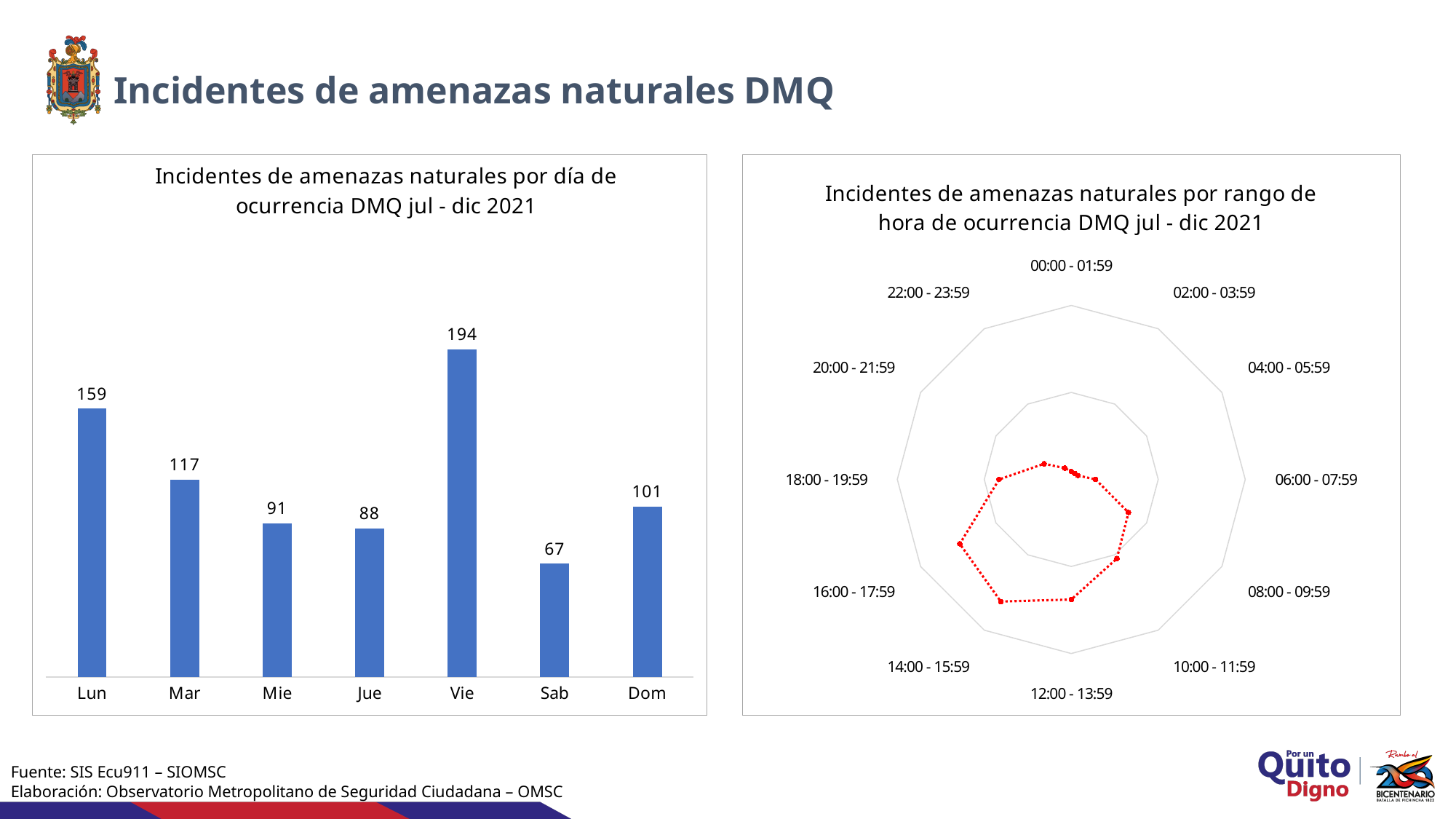
What kind of chart is the left chart 'Incidentes de amenazas naturales por día de ocurrencia DMQ jul - dic 2021'? Bar chart In the right chart 'Incidentes de amenazas naturales por rango de hora de ocurrencia DMQ jul - dic 2021', which time range has the highest value? 14:00 - 15:59 In the left chart 'Incidentes de amenazas naturales por día de ocurrencia DMQ jul - dic 2021', which day has the lowest value? Sab In the left chart 'Incidentes de amenazas naturales por día de ocurrencia DMQ jul - dic 2021', what is the value for Mar? 117 In the left chart 'Incidentes de amenazas naturales por día de ocurrencia DMQ jul - dic 2021', what is the value for Vie? 194 In the left chart 'Incidentes de amenazas naturales por día de ocurrencia DMQ jul - dic 2021', which day has the highest value? Vie In the left chart 'Incidentes de amenazas naturales por día de ocurrencia DMQ jul - dic 2021', what is the difference between the values for Lun and Mar? 42 In the left chart 'Incidentes de amenazas naturales por día de ocurrencia DMQ jul - dic 2021', which is larger, the value for Mie or the value for Jue? Mie In the left chart 'Incidentes de amenazas naturales por día de ocurrencia DMQ jul - dic 2021', what is the value for Dom? 101 In the left chart 'Incidentes de amenazas naturales por día de ocurrencia DMQ jul - dic 2021', what is the difference between the values for Vie and Sab? 127 How many days are shown in the left chart 'Incidentes de amenazas naturales por día de ocurrencia DMQ jul - dic 2021'? 7 How many time ranges are shown in the right chart 'Incidentes de amenazas naturales por rango de hora de ocurrencia DMQ jul - dic 2021'? 12